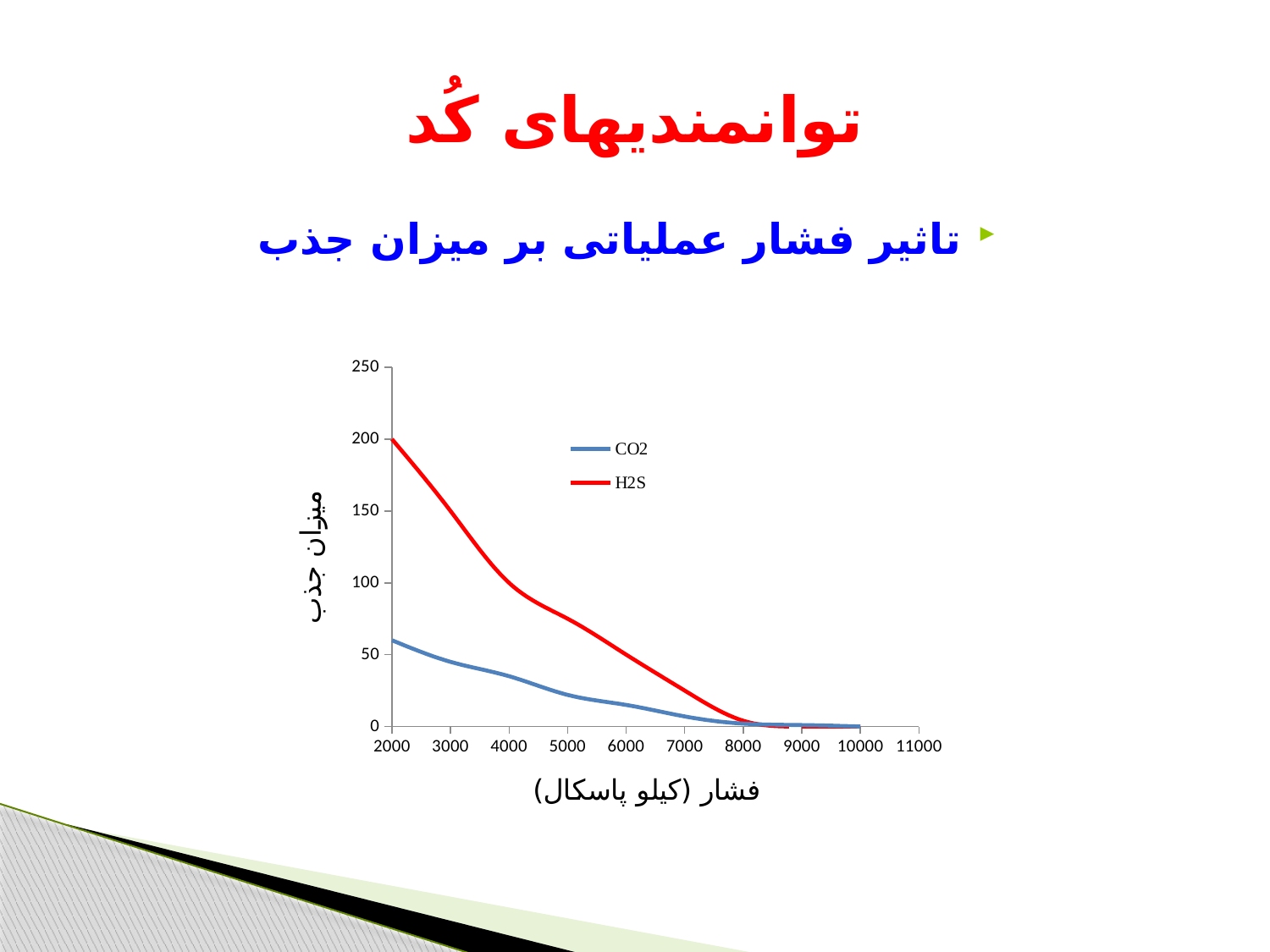
How many series does the chart's legend list? 2 What are the two series named in the chart's legend? CO2 and H2S Is the value of the H2S series at a pressure of 5000 greater or less than 100? less Is the value of the CO2 series at a pressure of 2000 greater or less than 100? less Which colour is used for the H2S line in the chart? red What kind of chart is shown on the slide? line chart At a pressure of 2000, which series has the larger value, CO2 or H2S? H2S What is the value of the H2S series at a pressure of 2000? 200 Do the values of the H2S series rise or fall as pressure increases along the x axis? fall Is the value of the H2S series at a pressure of 3000 greater or less than 100? greater Do the values of the CO2 series rise or fall as pressure increases along the x axis? fall